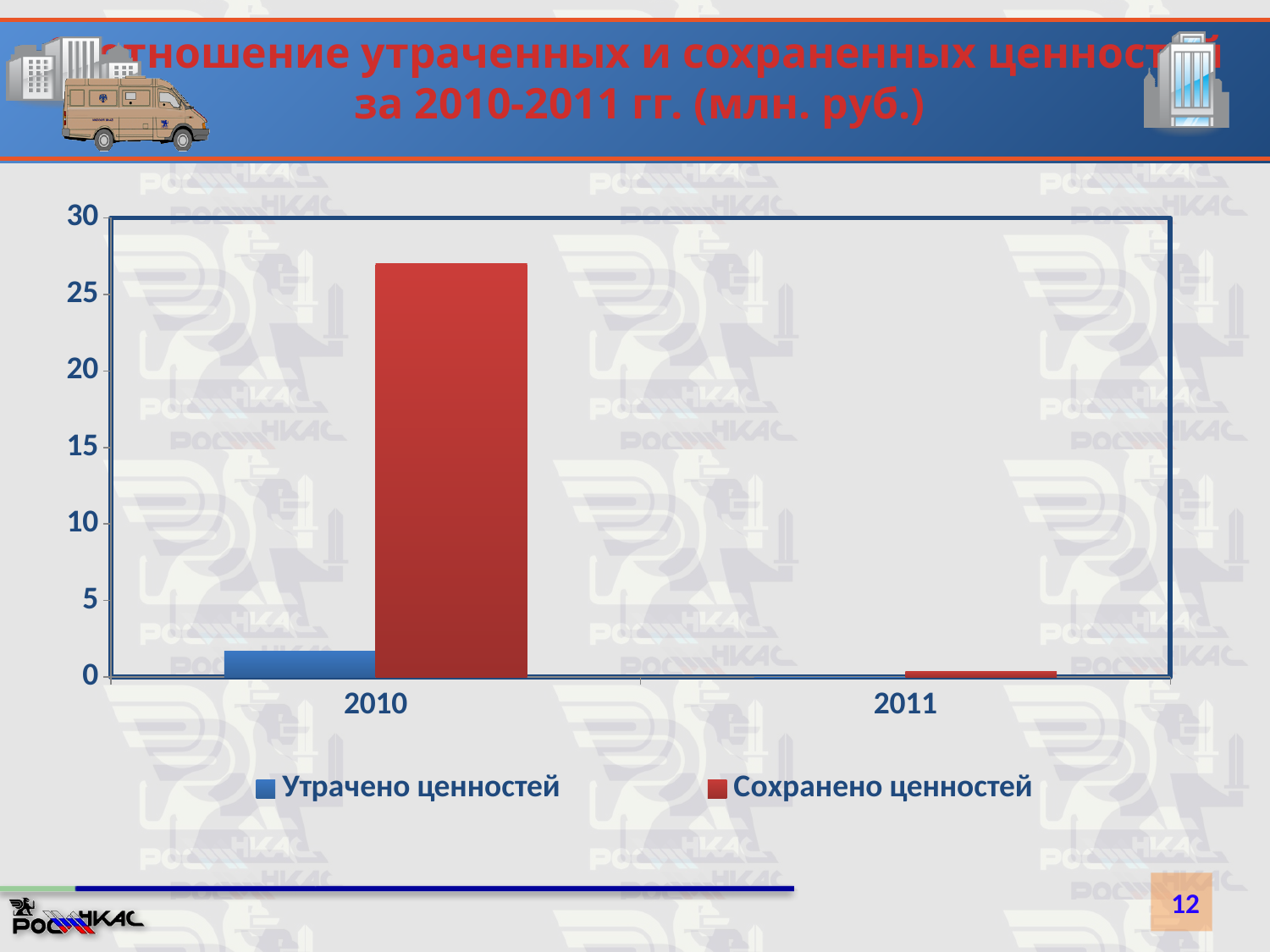
Which colour represents Утрачено ценностей in the legend? blue Is the value of Утрачено ценностей for 2010 greater or less than 5? less How many categories are shown on the x axis of the chart? 2 In which year is Сохранено ценностей highest? 2010 What kind of chart is shown on the slide? bar chart Is the value of Сохранено ценностей for 2010 greater or less than 25? greater Is the value of Сохранено ценностей for 2011 greater or less than 5? less Which is larger in 2010: Утрачено ценностей or Сохранено ценностей? Сохранено ценностей In what units are the values given, according to the slide title? млн. руб. How many series does the chart's legend list? 2 Does the value of Сохранено ценностей rise or fall from 2010 to 2011? fall For Сохранено ценностей, which year has the larger value: 2010 or 2011? 2010